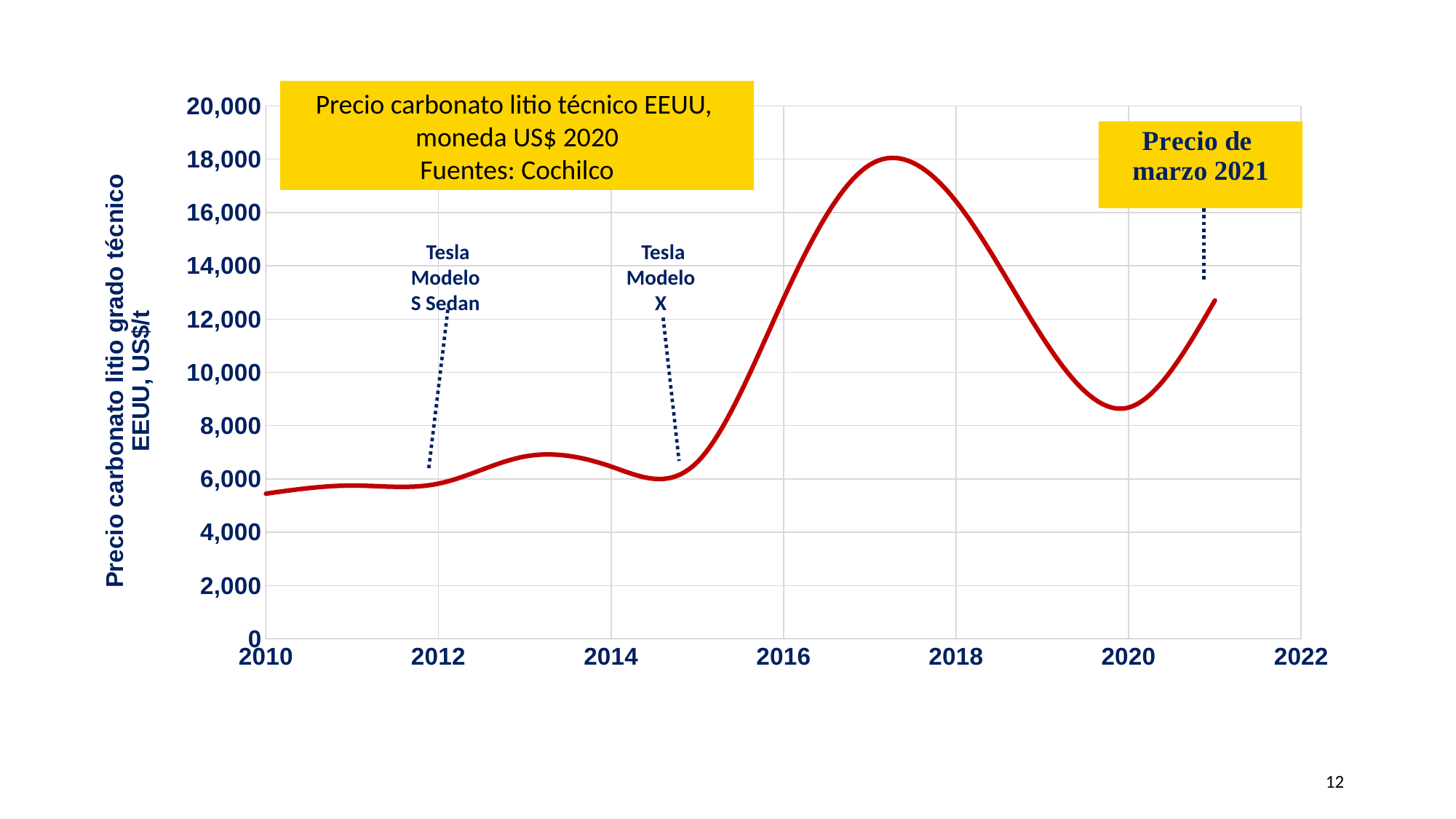
What source is cited for the chart data? Cochilco Is the peak value of the line greater or less than 16,000? greater What is the title of the chart? Precio carbonato litio técnico EEUU, moneda US$ 2020 Is the value at the end of the line (2021) greater or less than 12,000? greater Does the line rise or fall between 2018 and 2020? fall Does the line rise or fall between 2020 and 2021? rise What kind of chart is shown on the slide? line chart Which is larger, the value for 2016 or the value for 2014? 2016 Is the value for 2020 greater or less than 10,000? less